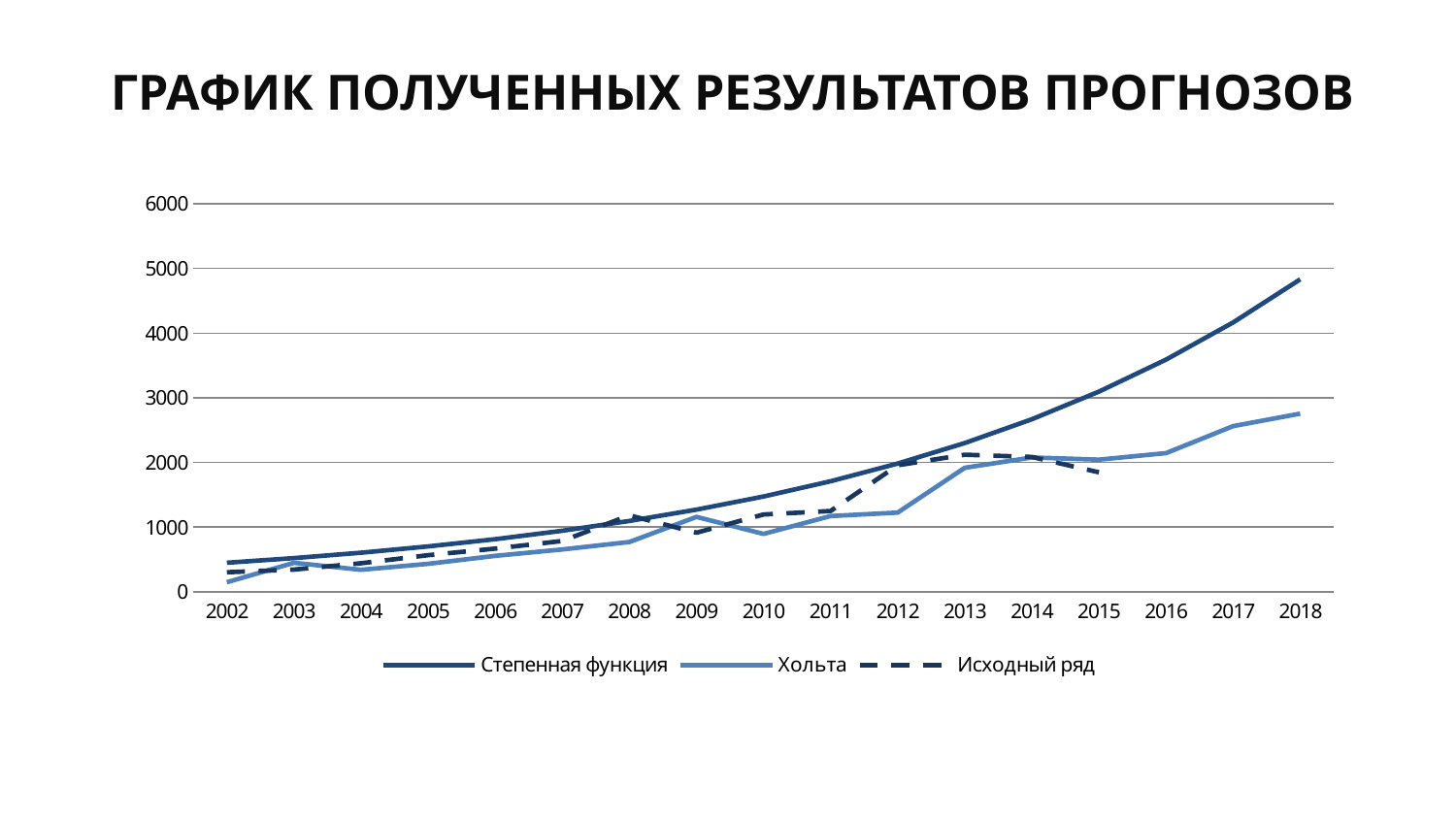
In which year does the Исходный ряд series end? 2015 How many series does the legend list? 3 Is the value for Хольта in 2002 greater or less than 1000? less Is the value for Хольта in 2018 greater or less than 3000? less Does the Степенная функция series rise or fall from 2002 to 2018? rises In 2010, which series has the higher value: Степенная функция or Хольта? Степенная функция Is the value for Степенная функция in 2016 greater or less than 3000? greater What kind of chart is shown on the slide? line chart How many years are shown on the x axis? 17 Which series is drawn with a dashed line? Исходный ряд In 2018, which series has the higher value: Степенная функция or Хольта? Степенная функция